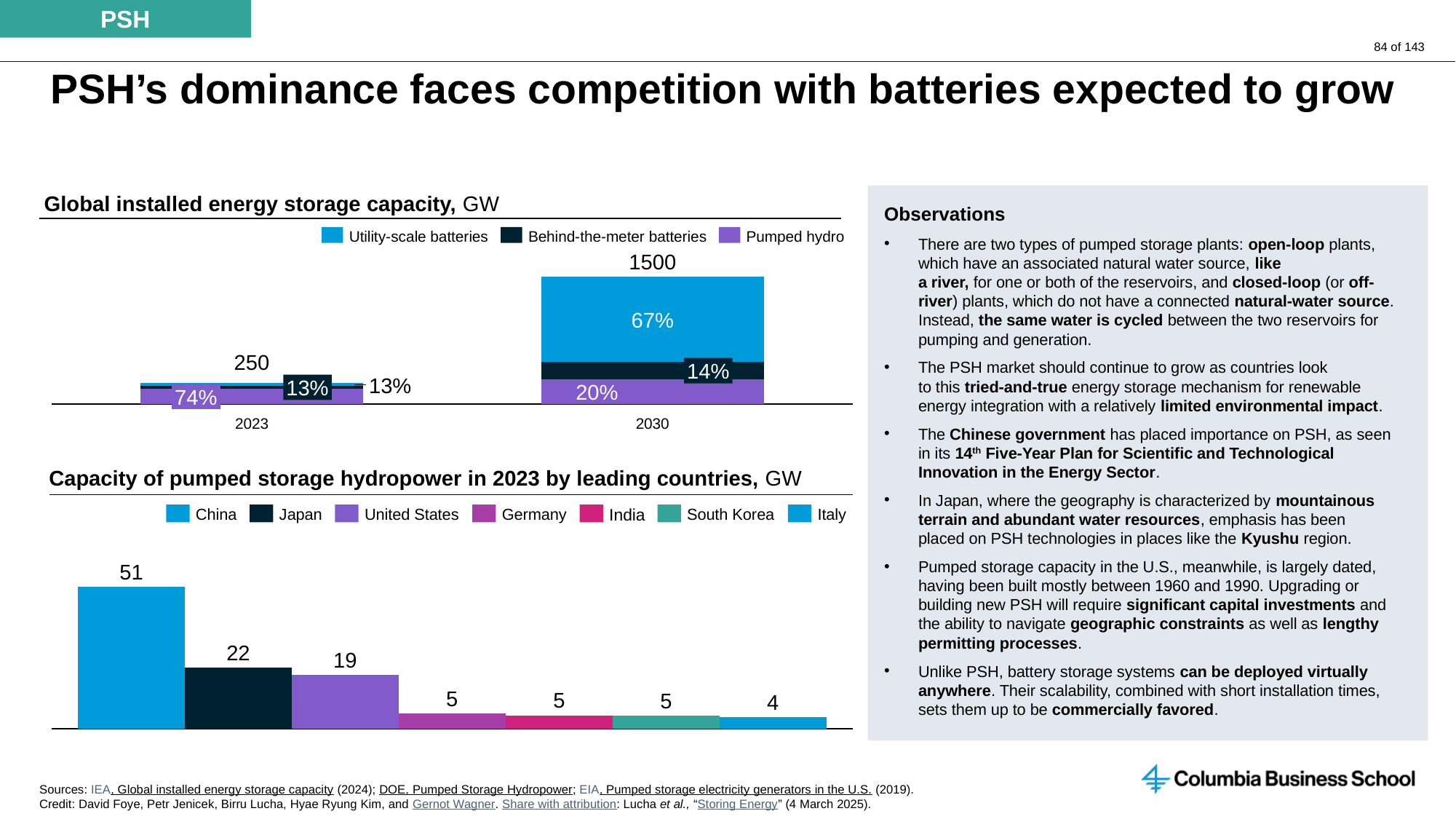
In the 'Capacity of pumped storage hydropower in 2023 by leading countries' chart, what is the capacity for Japan? 22 In the 'Global installed energy storage capacity' chart, what is the total installed capacity shown for 2030? 1500 In the 'Capacity of pumped storage hydropower in 2023 by leading countries' chart, what is the difference between China's and Japan's capacity? 29 What type of chart is the 'Capacity of pumped storage hydropower in 2023 by leading countries' chart? Bar chart In the 'Global installed energy storage capacity' chart, what share of the 2030 total is pumped hydro? 20% In the 'Capacity of pumped storage hydropower in 2023 by leading countries' chart, which country has the lowest capacity? Italy In the 'Capacity of pumped storage hydropower in 2023 by leading countries' chart, which country has the highest capacity? China In the 'Global installed energy storage capacity' chart, what share of the 2030 total is utility-scale batteries? 67% In the 'Global installed energy storage capacity' chart, what is the total installed capacity shown for 2023? 250 How many series does the legend of the 'Global installed energy storage capacity' chart list? 3 In the 'Global installed energy storage capacity' chart, what share of the 2023 total is pumped hydro? 74% In the 'Capacity of pumped storage hydropower in 2023 by leading countries' chart, what is the capacity for the United States? 19